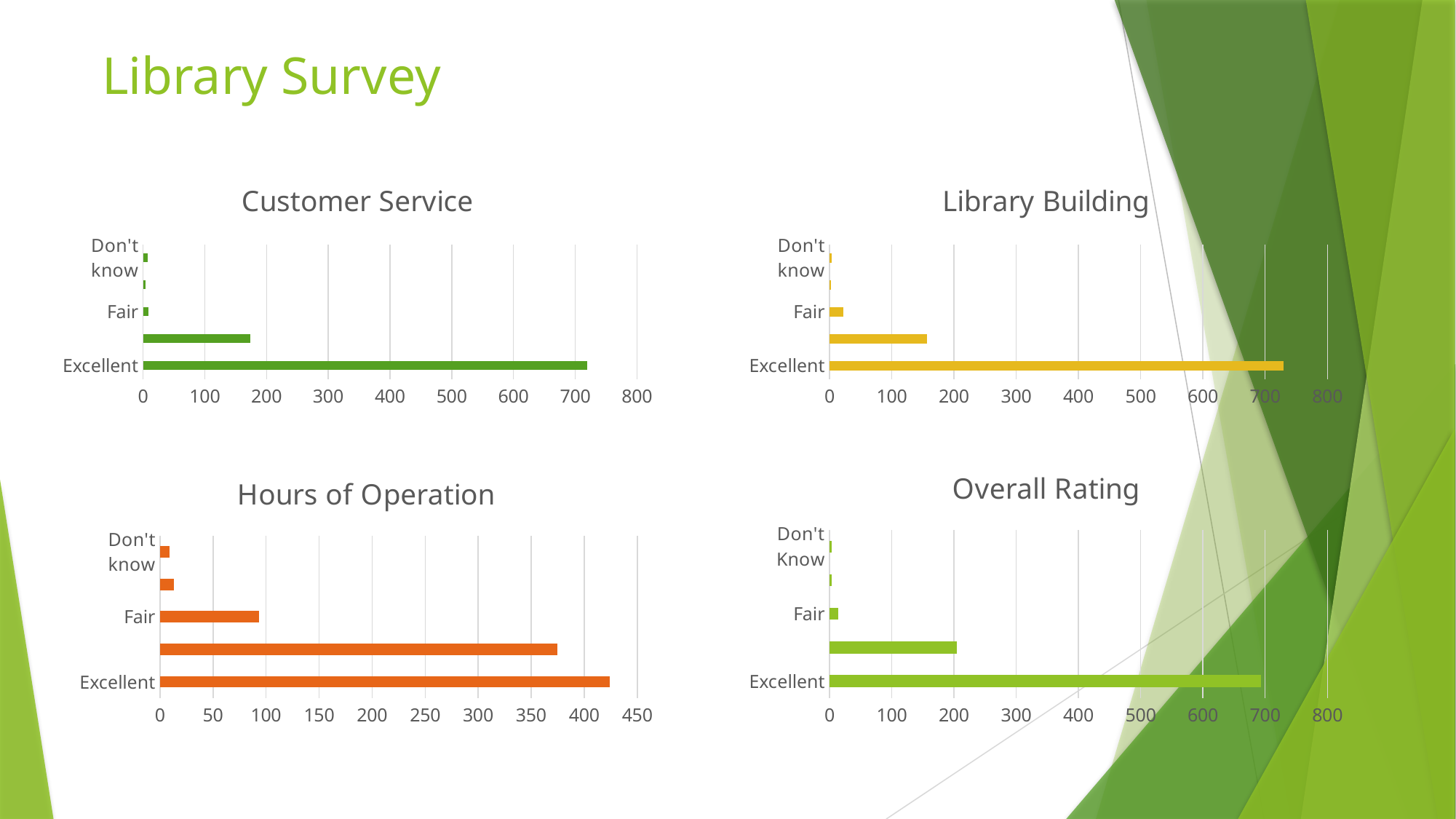
In the Customer Service chart, is the value for Fair greater or less than 100? less In the Overall Rating chart, which category has the highest value? Excellent In the Library Building chart, is the value for Excellent greater or less than 700? greater What kind of chart is the Customer Service chart? bar chart How many bars are plotted in the Hours of Operation chart? 5 In the Overall Rating chart, is the value for Excellent greater or less than 600? greater In the Library Building chart, which category has the highest value? Excellent In the Library Building chart, which is larger, the value for Excellent or the value for Fair? Excellent In the Customer Service chart, which category has the highest value? Excellent